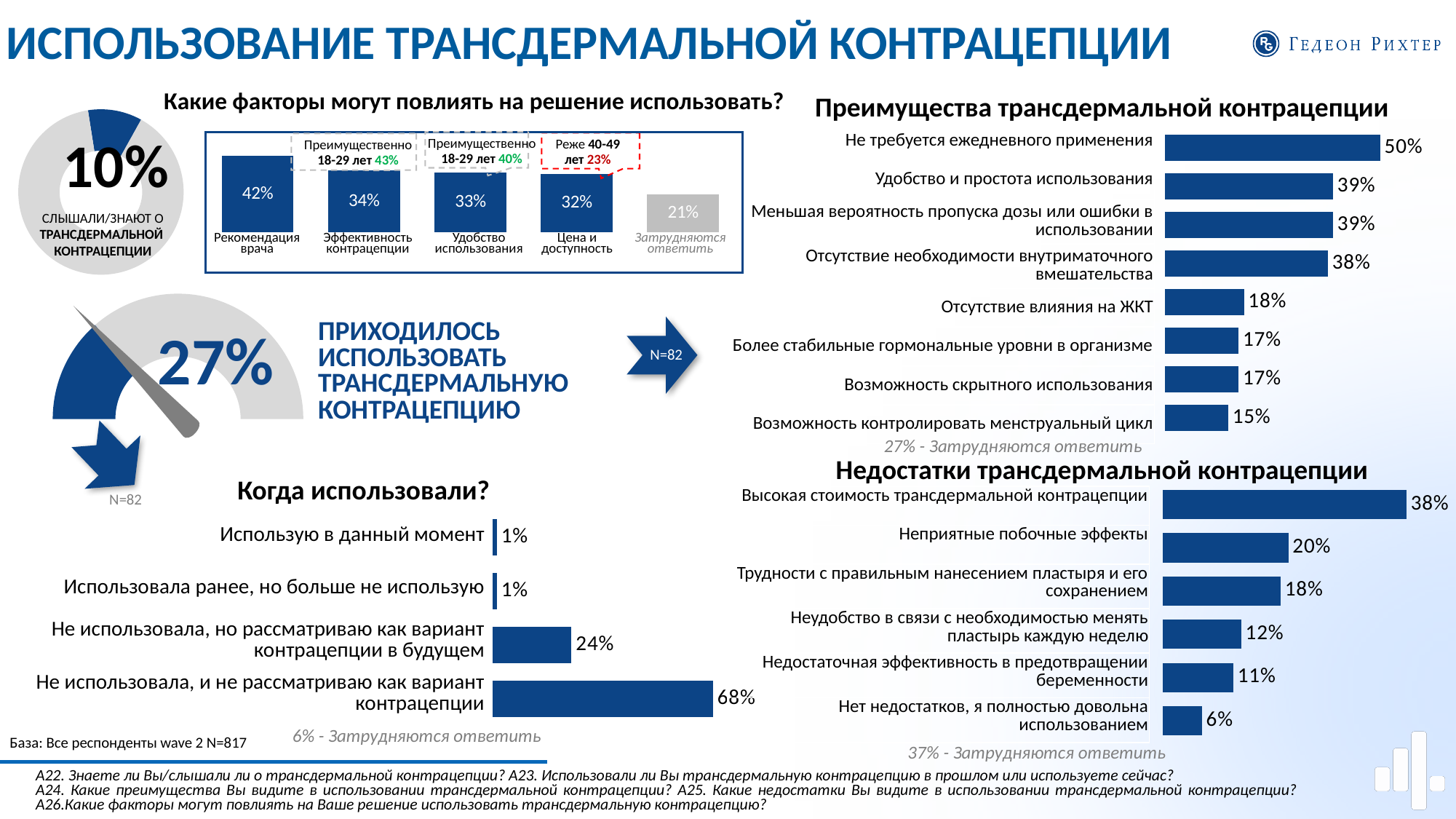
In the chart 'Какие факторы могут повлиять на решение использовать?', what is the difference between 'Рекомендация врача' and 'Цена и доступность'? 10% In the chart 'Недостатки трансдермальной контрацепции', what is the value for 'Неприятные побочные эффекты'? 20% In the chart 'Когда использовали?', which is larger: 'Использую в данный момент' or 'Не использовала, но рассматриваю как вариант контрацепции в будущем'? Не использовала, но рассматриваю как вариант контрацепции в будущем In the chart 'Недостатки трансдермальной контрацепции', what is the difference between 'Высокая стоимость трансдермальной контрацепции' and 'Нет недостатков, я полностью довольна использованием'? 32% In the chart 'Недостатки трансдермальной контрацепции', which category has the highest value? Высокая стоимость трансдермальной контрацепции In the chart 'Какие факторы могут повлиять на решение использовать?', how many categories are plotted? 5 In the chart 'Когда использовали?', what is the value for 'Не использовала, и не рассматриваю как вариант контрацепции'? 68% What kind of chart is 'Когда использовали?'? Bar chart In the chart 'Преимущества трансдермальной контрацепции', what is the value for 'Не требуется ежедневного применения'? 50% In the chart 'Преимущества трансдермальной контрацепции', how many categories are plotted? 8 In the chart 'Преимущества трансдермальной контрацепции', which category has the lowest value? Возможность контролировать менструальный цикл In the chart 'Какие факторы могут повлиять на решение использовать?', what is the value for 'Рекомендация врача'? 42%